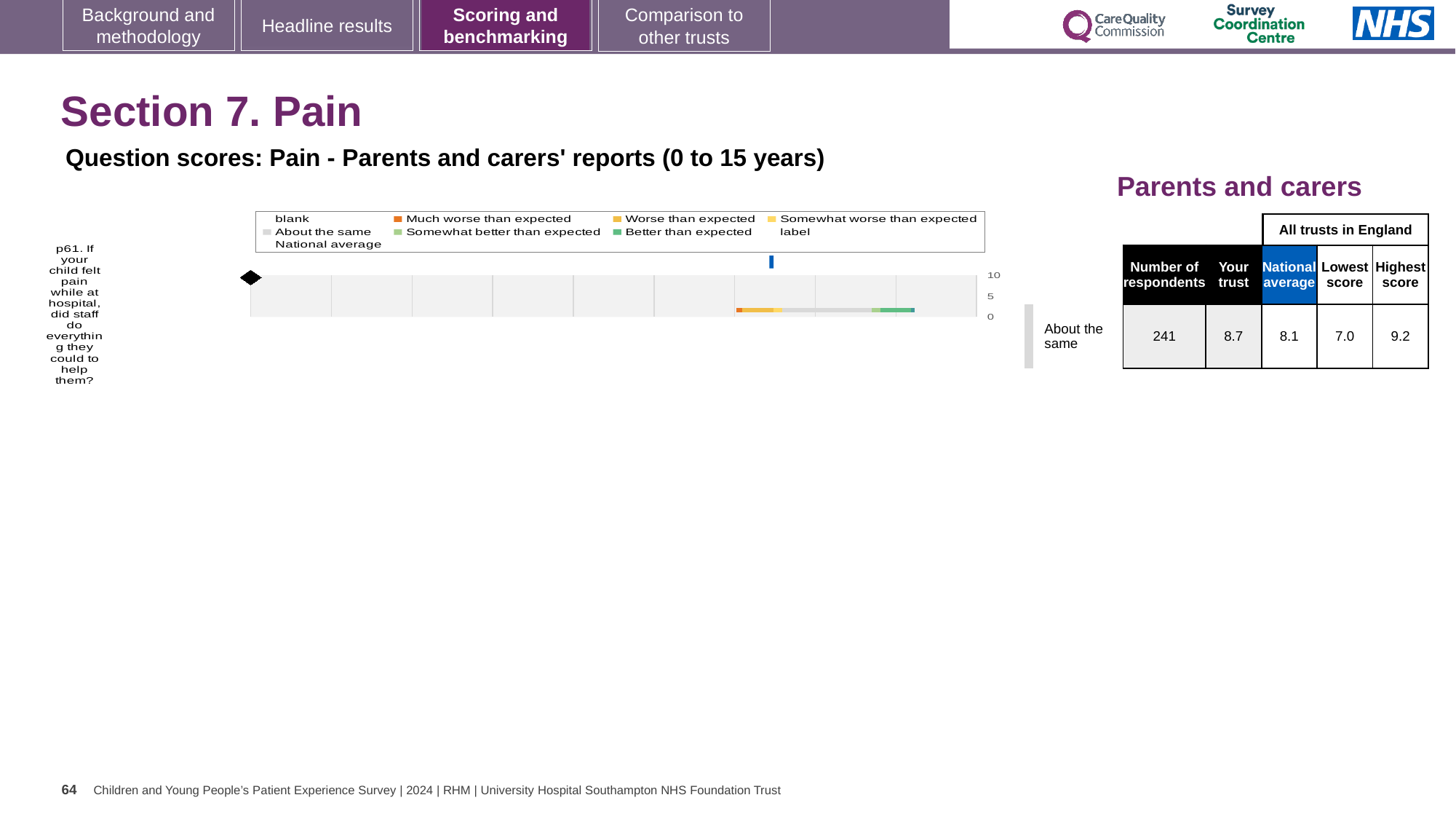
In the table next to the chart, what is the National average score for p61? 8.1 In the table next to the chart, what is the 'Your trust' score for p61? 8.7 In the table next to the chart, what is the Highest score across all trusts in England for p61? 9.2 What kind of chart is shown on the slide? bar chart In the table next to the chart, how many respondents answered p61? 241 According to the table next to the chart, what is the difference between the Highest score and the Lowest score for p61? 2.2 What is the question number of the item plotted on the chart? p61 What benchmark category is the trust's p61 score placed in, as shown beside the chart? About the same According to the table next to the chart, is the trust's score for p61 higher or lower than the National average? higher In the table next to the chart, what is the Lowest score across all trusts in England for p61? 7.0 What is the highest tick value shown on the chart's score axis? 10 How many survey questions are plotted on the chart? 1